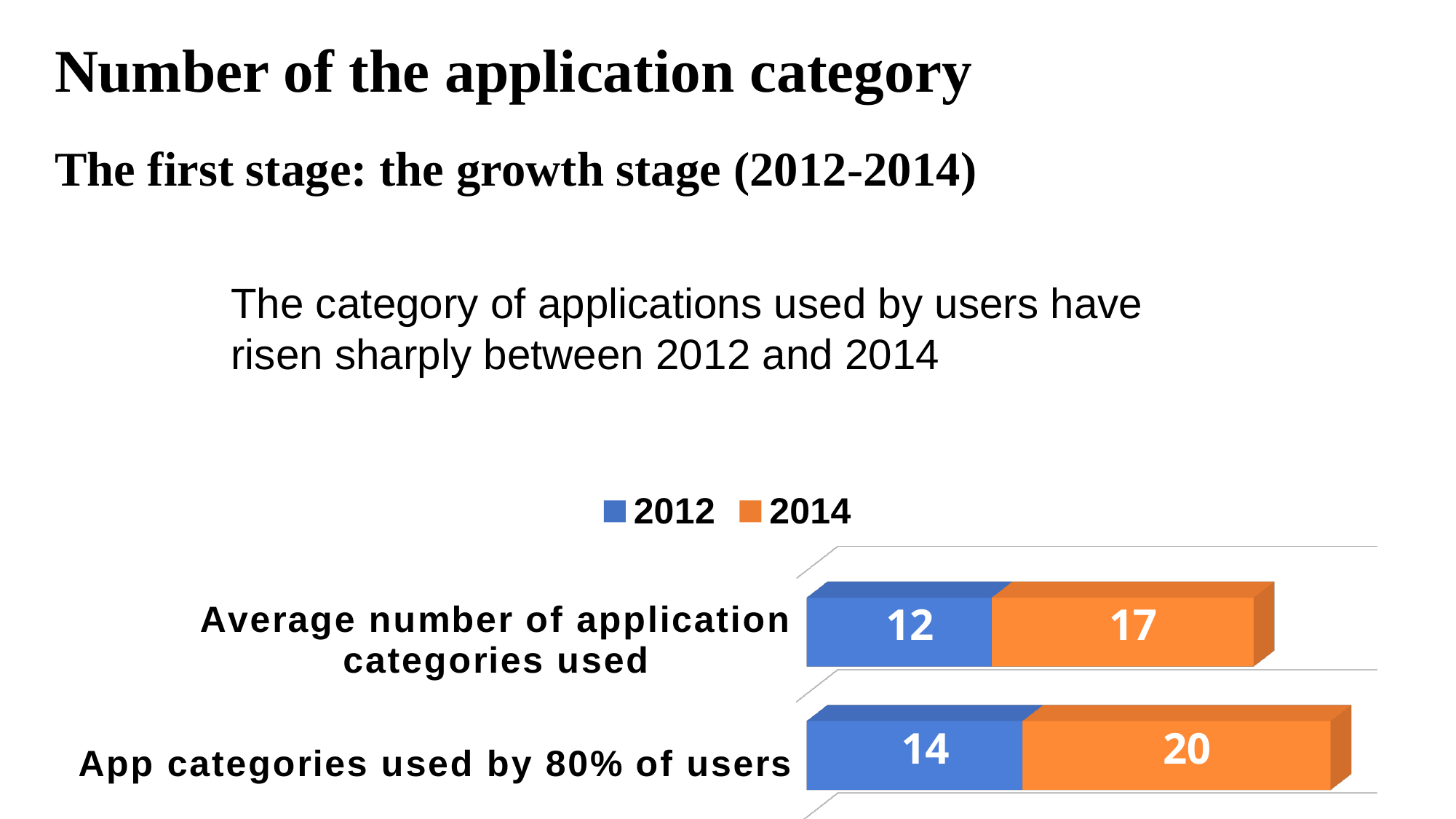
What is the 2012 value for Average number of application categories used? 12 What is the total of the stacked bar for App categories used by 80% of users? 34 What is the difference between the 2014 and 2012 values for App categories used by 80% of users? 6 What is the 2014 value for App categories used by 80% of users? 20 How many series does the legend list? 2 Which is larger for App categories used by 80% of users, the 2012 value or the 2014 value? 2014 What is the 2012 value for App categories used by 80% of users? 14 Which category has the highest 2014 value? App categories used by 80% of users Which category has the lowest 2012 value? Average number of application categories used What is the 2014 value for Average number of application categories used? 17 What is the difference between the 2014 and 2012 values for Average number of application categories used? 5 What kind of chart is shown on the slide? Stacked bar chart